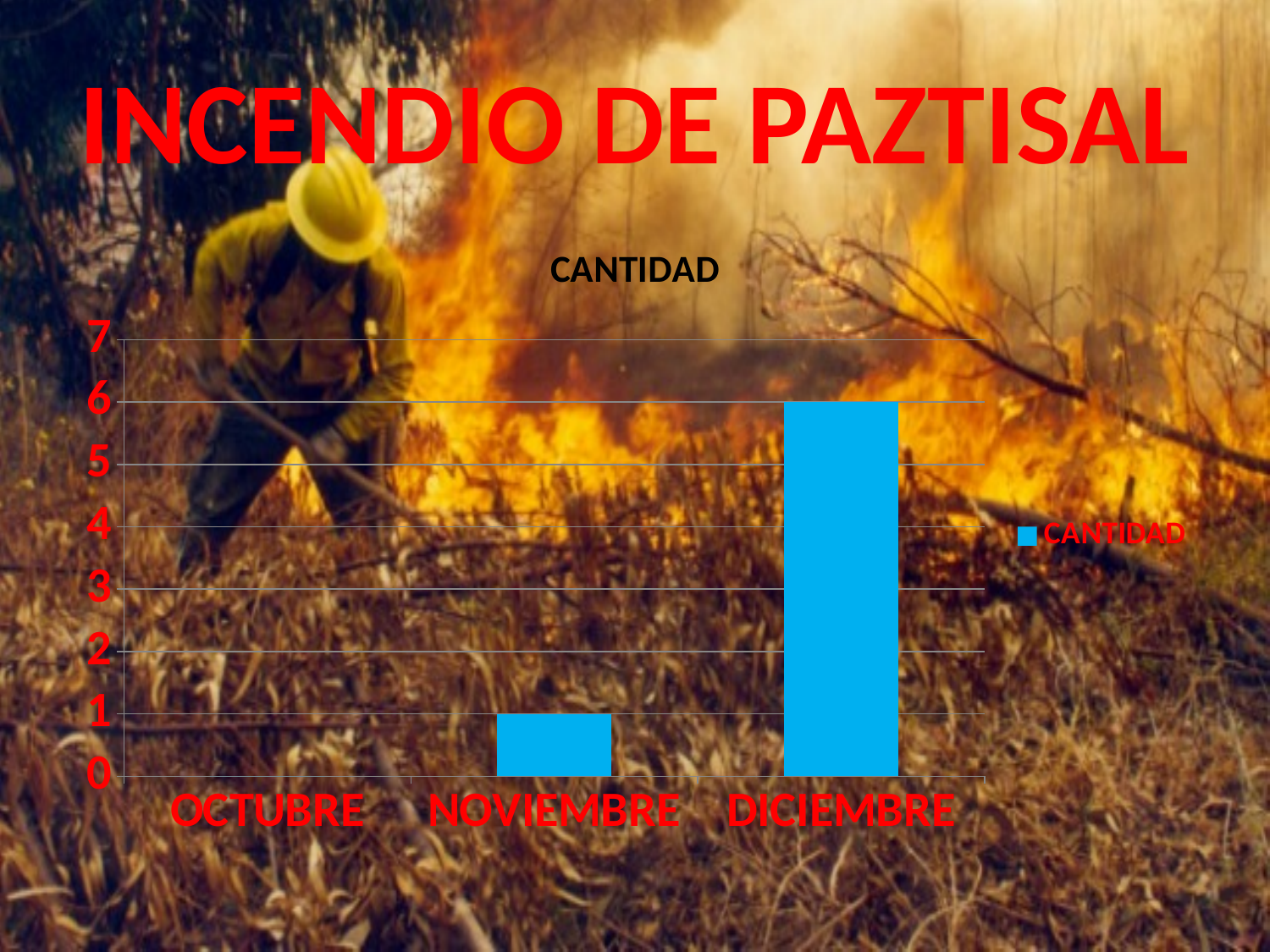
What is the difference between the values for DICIEMBRE and NOVIEMBRE? 5 What is the value for NOVIEMBRE? 1 What is the value for DICIEMBRE? 6 Which is larger, the value for NOVIEMBRE or the value for DICIEMBRE? DICIEMBRE Which month has the highest value? DICIEMBRE Do the values rise or fall from OCTUBRE to DICIEMBRE? rise Which month has the lowest value? OCTUBRE How many series does the legend list? 1 Is the value for DICIEMBRE greater or less than 4? greater What type of chart is shown on the slide? bar chart What is the title of the chart? CANTIDAD How many categories are shown on the x axis of the chart? 3